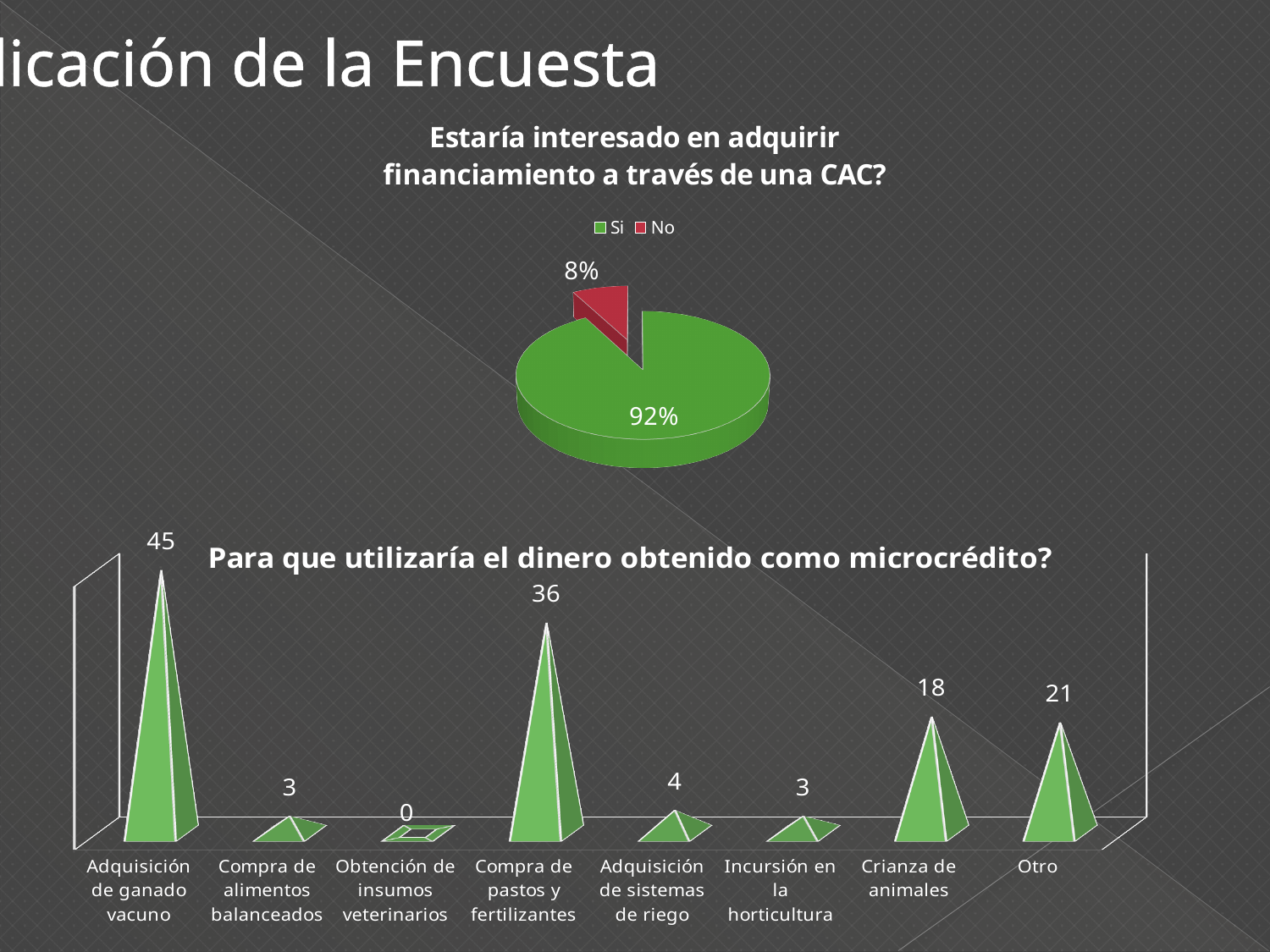
In the chart titled 'Para que utilizaría el dinero obtenido como microcrédito?', which category has the highest value? Adquisición de ganado vacuno What kind of chart is the one titled 'Estaría interesado en adquirir financiamiento a través de una CAC?'? Pie chart In the chart titled 'Estaría interesado en adquirir financiamiento a través de una CAC?', what percentage answered 'Si'? 92% In the chart titled 'Para que utilizaría el dinero obtenido como microcrédito?', what is the value for 'Adquisición de ganado vacuno'? 45 In the chart titled 'Estaría interesado en adquirir financiamiento a través de una CAC?', what percentage answered 'No'? 8% How many entries does the legend of the pie chart 'Estaría interesado en adquirir financiamiento a través de una CAC?' list? 2 What kind of chart is the one titled 'Para que utilizaría el dinero obtenido como microcrédito?'? Bar chart In the chart titled 'Para que utilizaría el dinero obtenido como microcrédito?', what is the value for 'Crianza de animales'? 18 In the chart titled 'Para que utilizaría el dinero obtenido como microcrédito?', which category has the lowest value? Obtención de insumos veterinarios How many categories are shown in the chart titled 'Para que utilizaría el dinero obtenido como microcrédito?'? 8 In the chart titled 'Para que utilizaría el dinero obtenido como microcrédito?', what is the difference between 'Adquisición de ganado vacuno' and 'Compra de pastos y fertilizantes'? 9